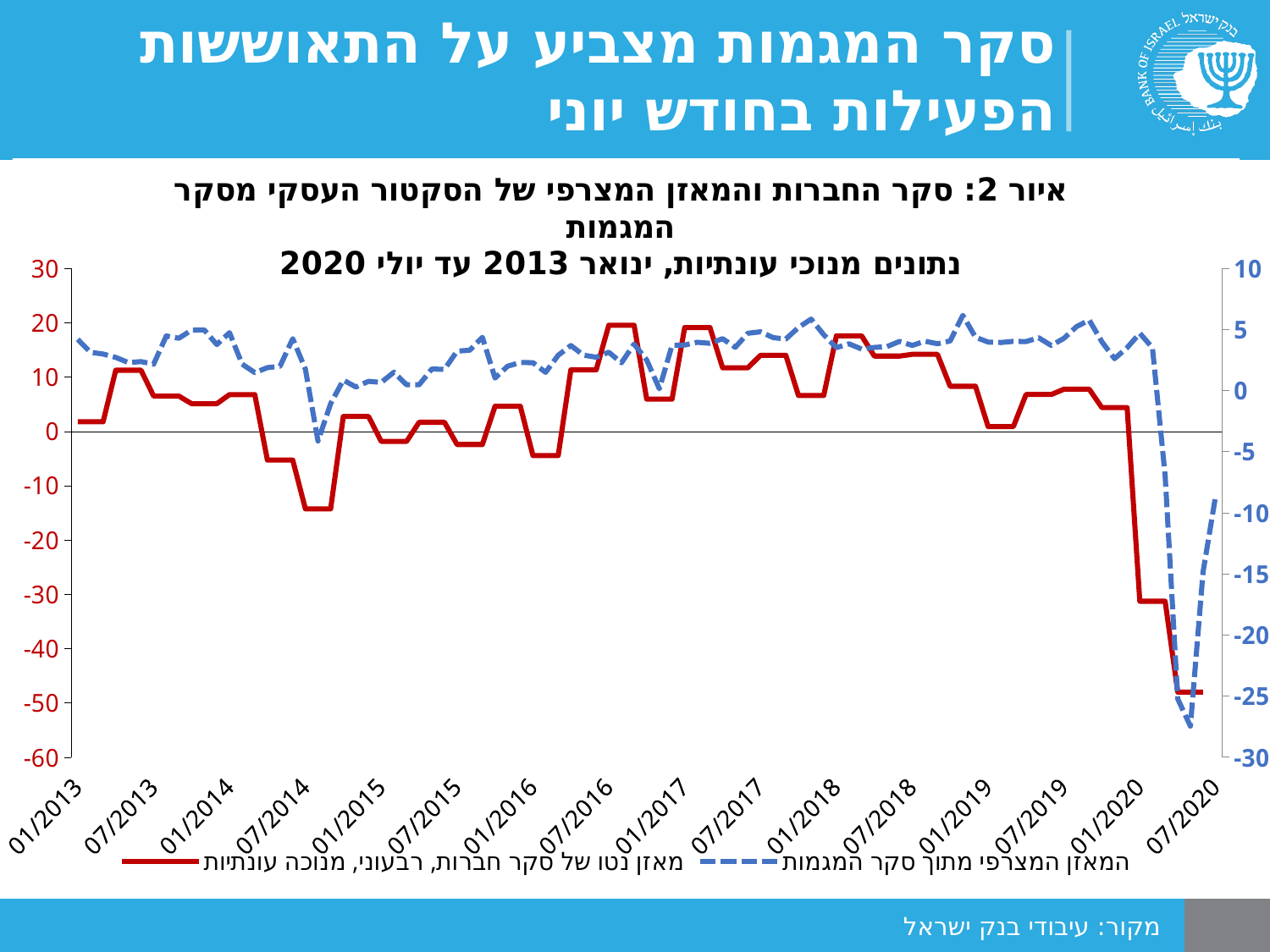
How many series does the legend list? 2 In which year does the red solid line reach its lowest value? 2020 What is the highest value shown on the right-hand vertical axis? 10 Is the value of the red solid line around 07/2014 greater or less than -10 on the left axis? less Which series is drawn as a dashed blue line? המאזן המצרפי מתוך סקר המגמות What kind of chart is shown on the slide? line chart Is the lowest point of the blue dashed line greater or less than -25 on the right axis? less How many date labels are shown along the x axis? 16 After reaching its low point in 2020, does the blue dashed line rise or fall toward 07/2020? rise Is the value of the red solid line at 07/2020 greater or less than -40 on the left axis? less Which is larger for the red solid line: the value at 01/2016 or the value at 07/2016? 07/2016